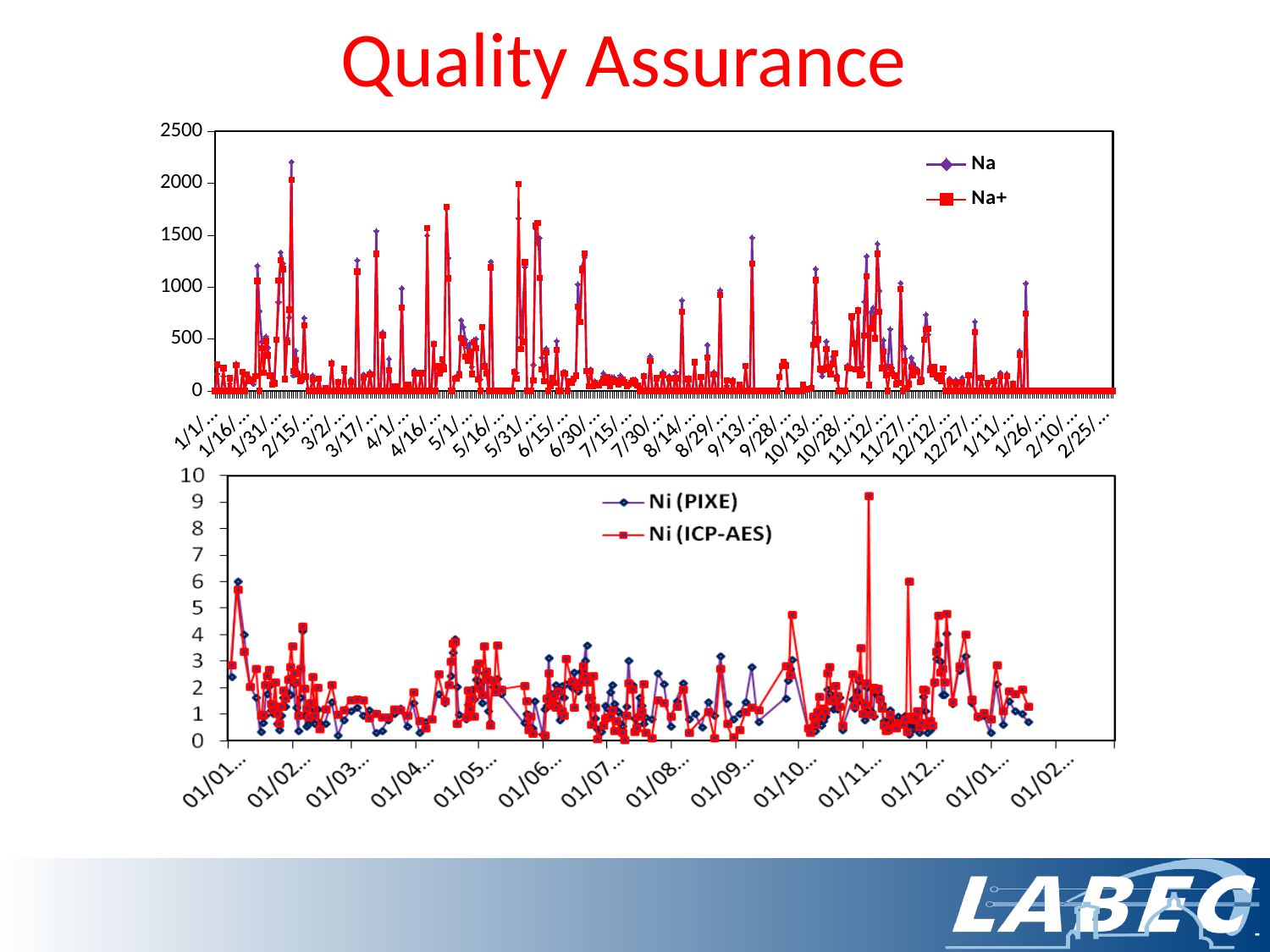
In the top chart, are the values in the final stretch (from about 1/26 to 2/25) greater or less than 500? less How many series does the legend of the bottom chart list? 2 In the top chart, what are the two series named in the legend? Na and Na+ In the bottom chart, what are the two series named in the legend? Ni (PIXE) and Ni (ICP-AES) In the bottom chart, is the Ni (PIXE) peak near 01/01 (the first spike) greater or less than 5? greater What is the maximum value shown on the y axis of the top chart? 2500 In the bottom chart, is the highest Ni (ICP-AES) peak (around 01/11) greater or less than 8? greater What kind of chart is the top chart on the slide? line chart What kind of chart is the bottom chart on the slide? line chart How many series does the legend of the top chart list? 2